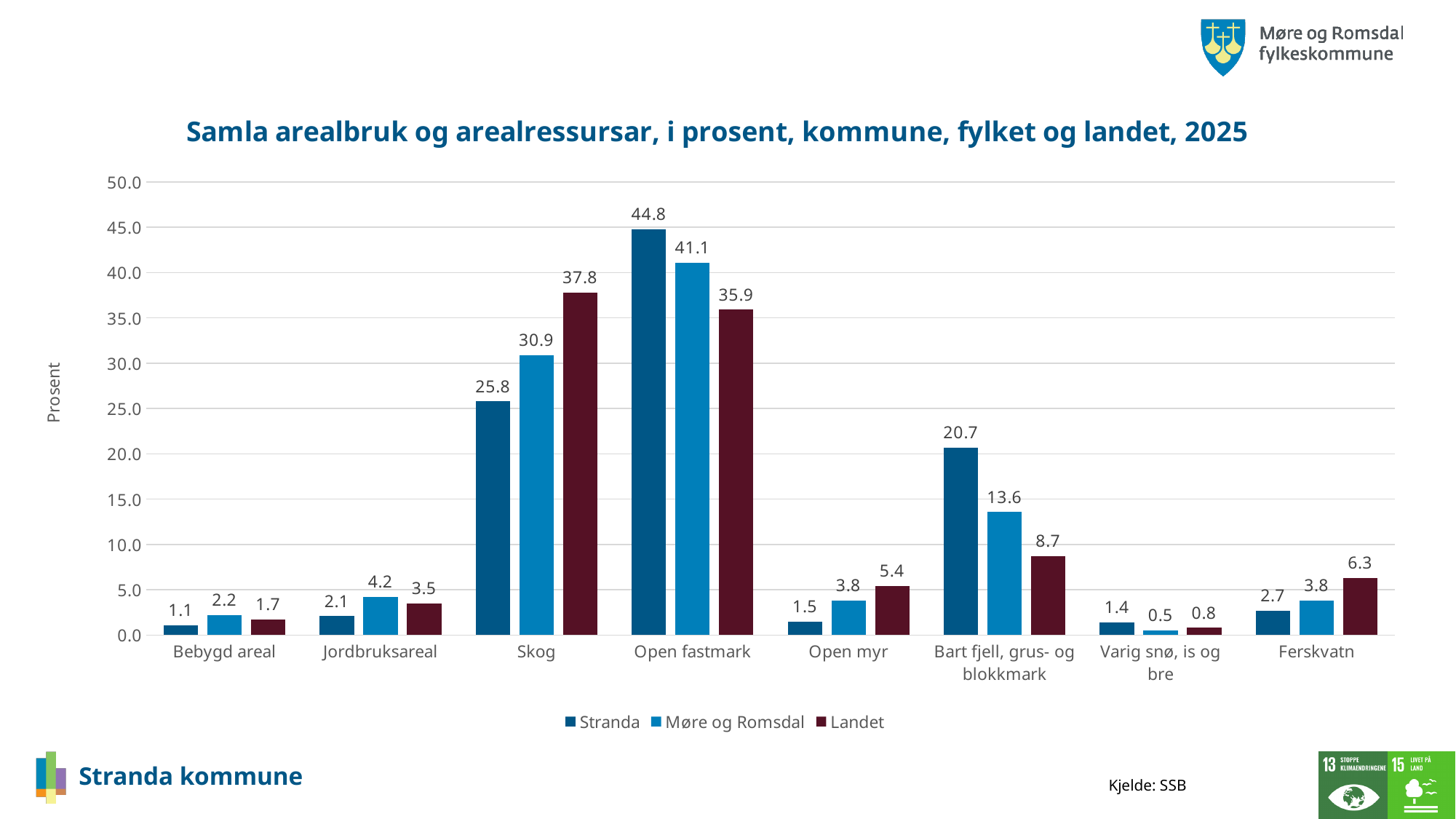
Which category has the lowest value for Møre og Romsdal? Varig snø, is og bre What is the value for Stranda in the Open fastmark category? 44.8 How many categories are shown on the x axis? 8 Which category has the highest value for Stranda? Open fastmark What is the difference between the Stranda and Landet values for Bart fjell, grus- og blokkmark? 12.0 How many series does the legend list? 3 Which is larger in the Skog category: Stranda or Landet? Landet What kind of chart is shown on the slide? Bar chart Is the value for Møre og Romsdal in the Open fastmark category greater or less than 40.0? greater What is the label of the y axis? Prosent What is the value for Møre og Romsdal in the Bart fjell, grus- og blokkmark category? 13.6 What is the value for Landet in the Skog category? 37.8